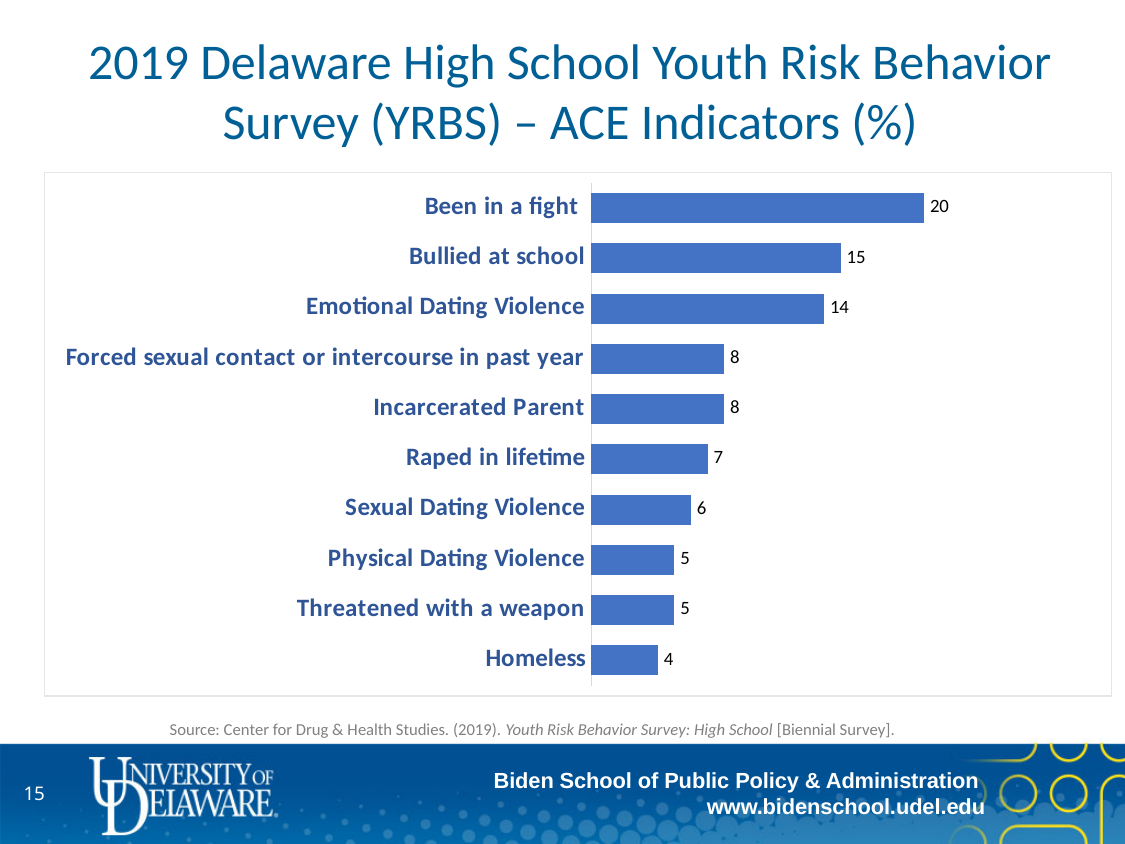
What is the difference between the values for Been in a fight and Bullied at school? 5 What is the value for Raped in lifetime? 7 Which category has the lowest value? Homeless What is the value for Homeless? 4 What is the difference between the values for Emotional Dating Violence and Sexual Dating Violence? 8 Which category has the highest value? Been in a fight Which is larger, the value for Incarcerated Parent or the value for Physical Dating Violence? Incarcerated Parent What is the value for Been in a fight? 20 What kind of chart is shown on the slide? Bar chart How many categories are shown in the chart? 10 What is the title of the slide? 2019 Delaware High School Youth Risk Behavior Survey (YRBS) – ACE Indicators (%) What is the value for Emotional Dating Violence? 14